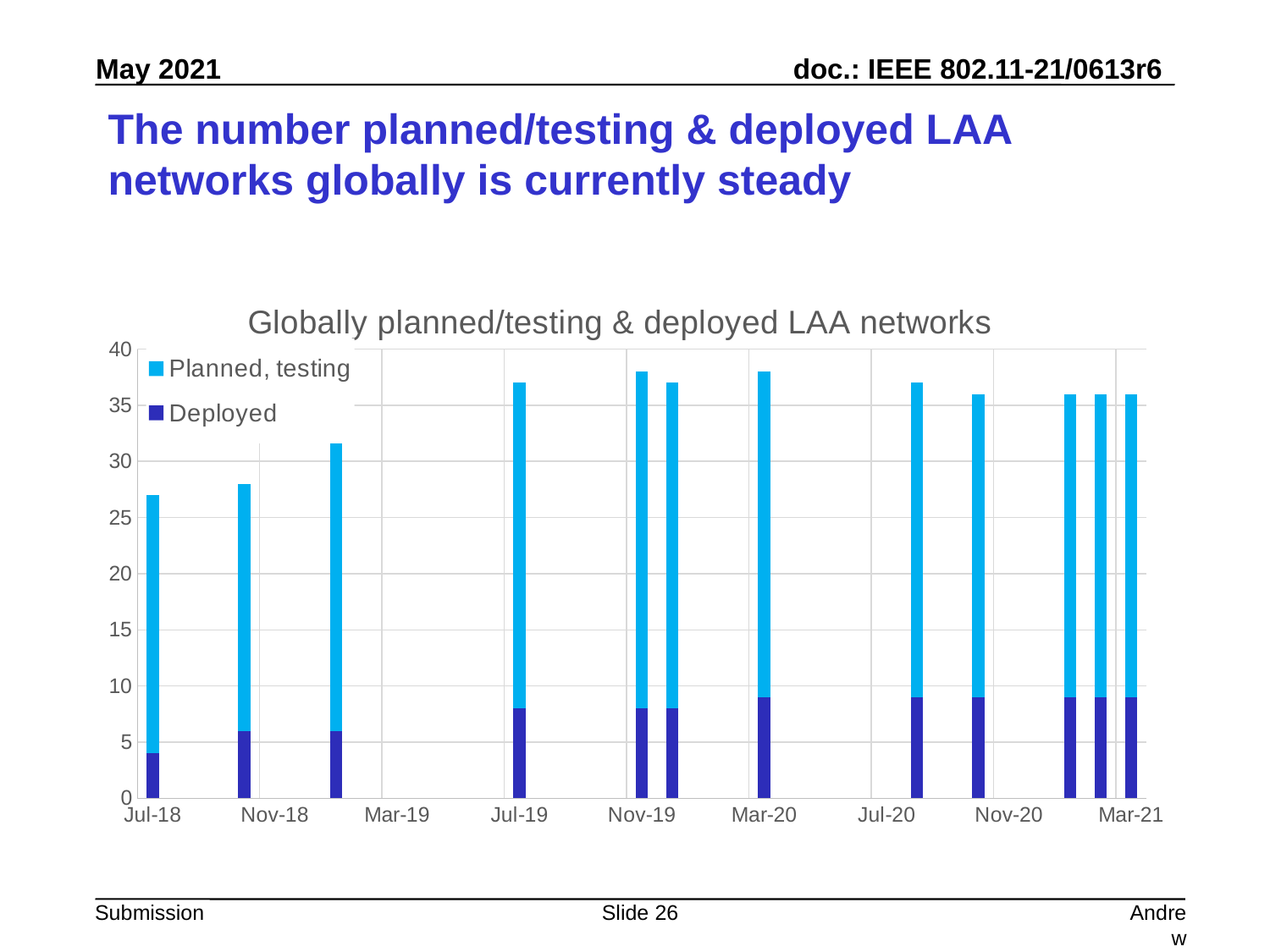
At Jul-19, which series accounts for the larger part of the bar, Planned, testing or Deployed? Planned, testing Is the Deployed value for Mar-21 greater or less than 10? less Is the total height of the Jul-19 bar greater or less than 35? greater Is the total height of the Jul-18 bar greater or less than 30? less How many series does the legend list? 2 Which bar has the lowest total, Jul-18 or Mar-21? Jul-18 Which date has the lowest total bar in the chart? Jul-18 What is the title of the chart? Globally planned/testing & deployed LAA networks Do the total bar heights generally rise or fall from Jul-18 to Mar-21? rise What are the two series named in the legend? Planned, testing; Deployed What kind of chart is shown on the slide? Stacked bar chart